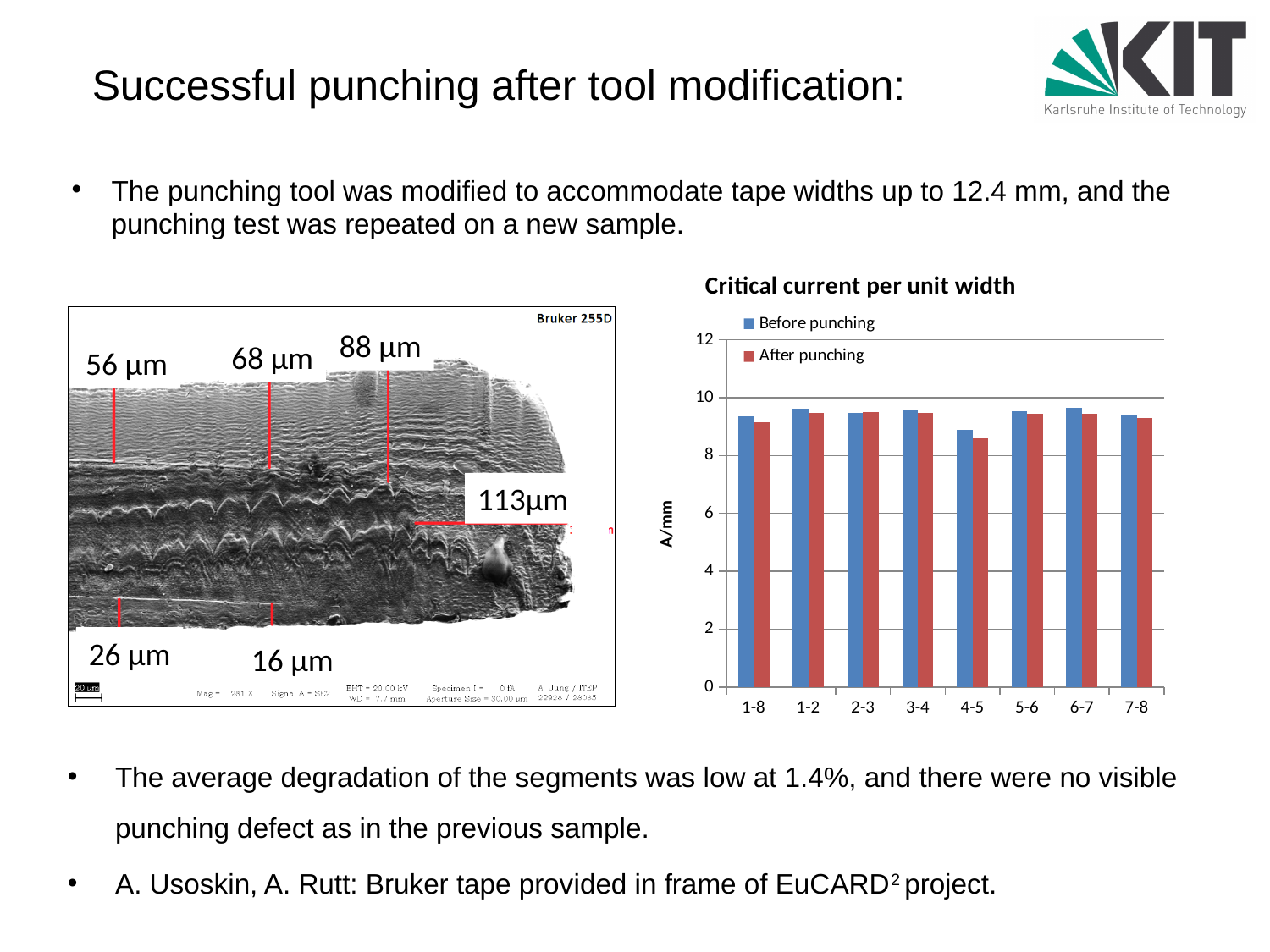
How many series does the chart's legend list? 2 What is the label of the y axis of the chart? A/mm Is the 'Before punching' value for segment 4-5 greater or less than 10? less Which is larger, the 'Before punching' value for segment 6-7 or for segment 4-5? 6-7 What is the title of the chart? Critical current per unit width Which segment has the lowest 'After punching' value? 4-5 Which segment has the lowest 'Before punching' value? 4-5 Is the 'After punching' value for segment 4-5 greater or less than 8? greater What kind of chart is shown on the slide? bar chart For segment 4-5, which is larger, the 'Before punching' value or the 'After punching' value? Before punching Is the 'Before punching' value for segment 6-7 greater or less than 8? greater How many segment categories are shown on the x axis of the chart? 8